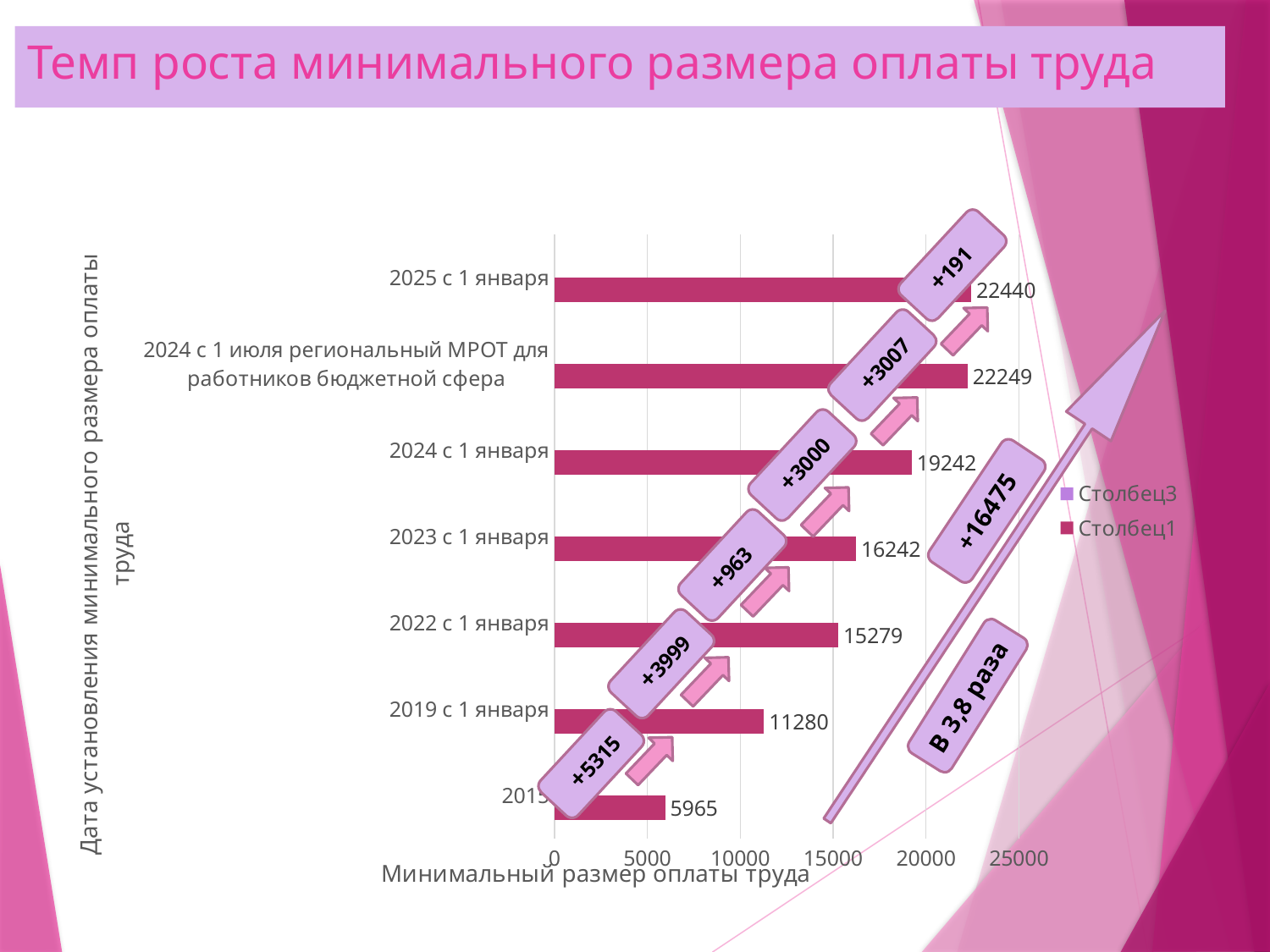
Which is larger, the value for "2022 с 1 января" or the value for "2019 с 1 января"? 2022 с 1 января How many bars are plotted in the chart? 7 How many series does the legend list? 2 What is the value for "2024 с 1 июля региональный МРОТ для работников бюджетной сфера"? 22249 What is the value for "2019 с 1 января"? 11280 What is the value for "2023 с 1 января"? 16242 What is the title of the horizontal axis? Минимальный размер оплаты труда Which category has the highest value? 2025 с 1 января What type of chart is shown on the slide? bar chart What is the value for "2025 с 1 января"? 22440 What is the value of the bottom bar in the chart? 5965 What is the difference between the values for "2024 с 1 января" and "2023 с 1 января"? 3000